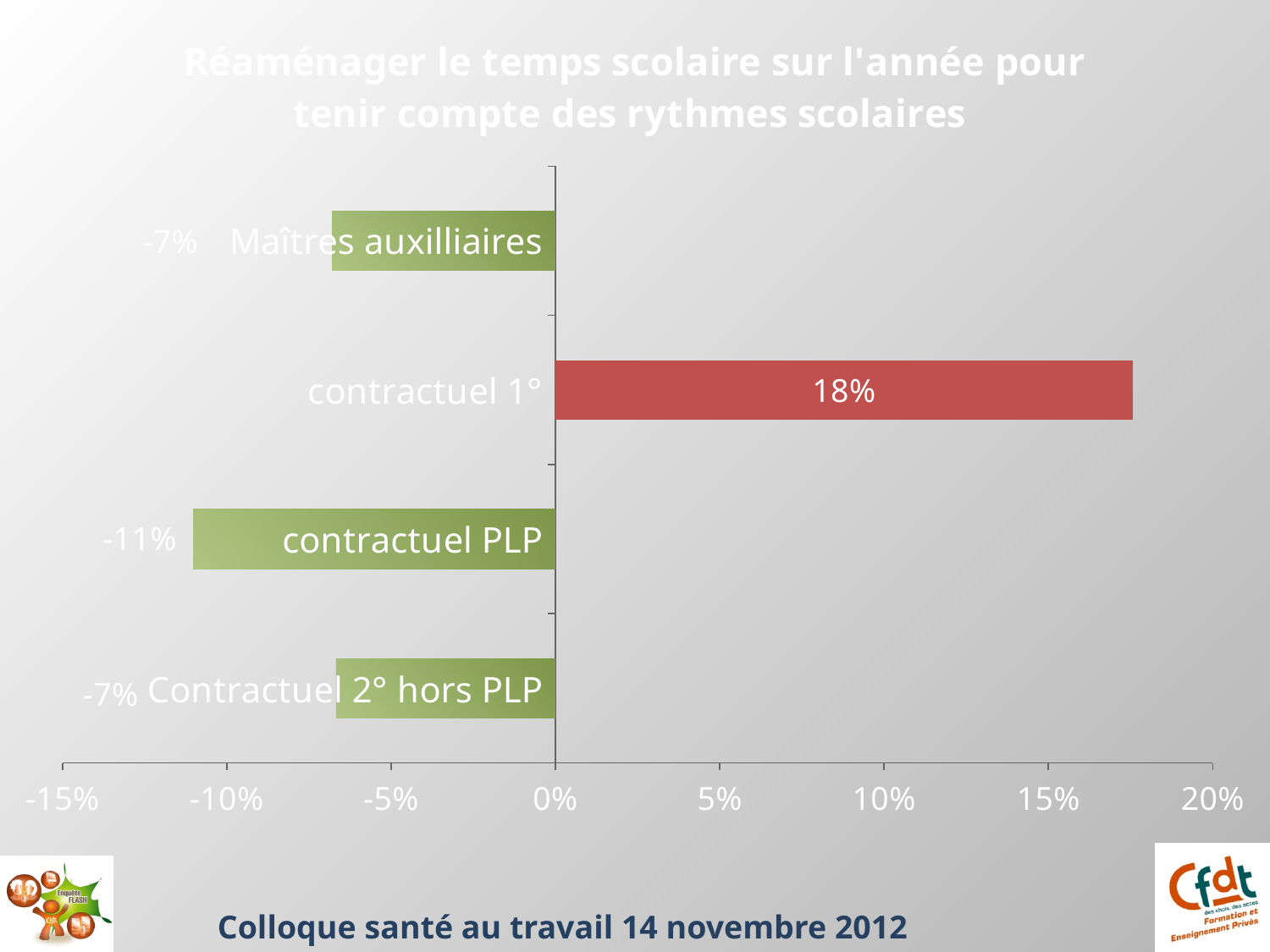
Which category has the highest value? contractuel 1° How many categories are shown in the chart? 4 What kind of chart is shown on the slide? bar chart What is the value for Maîtres auxilliaires? -7% What is the value for contractuel 1°? 18% What is the title of the chart? Réaménager le temps scolaire sur l'année pour tenir compte des rythmes scolaires Which is larger, the value for Maîtres auxilliaires or the value for contractuel PLP? Maîtres auxilliaires What is the value for Contractuel 2° hors PLP? -7% Is the value for contractuel 1° greater or less than 15%? greater Which category has the lowest value? contractuel PLP What is the value for contractuel PLP? -11% What is the difference between the values for contractuel 1° and contractuel PLP? 29 percentage points